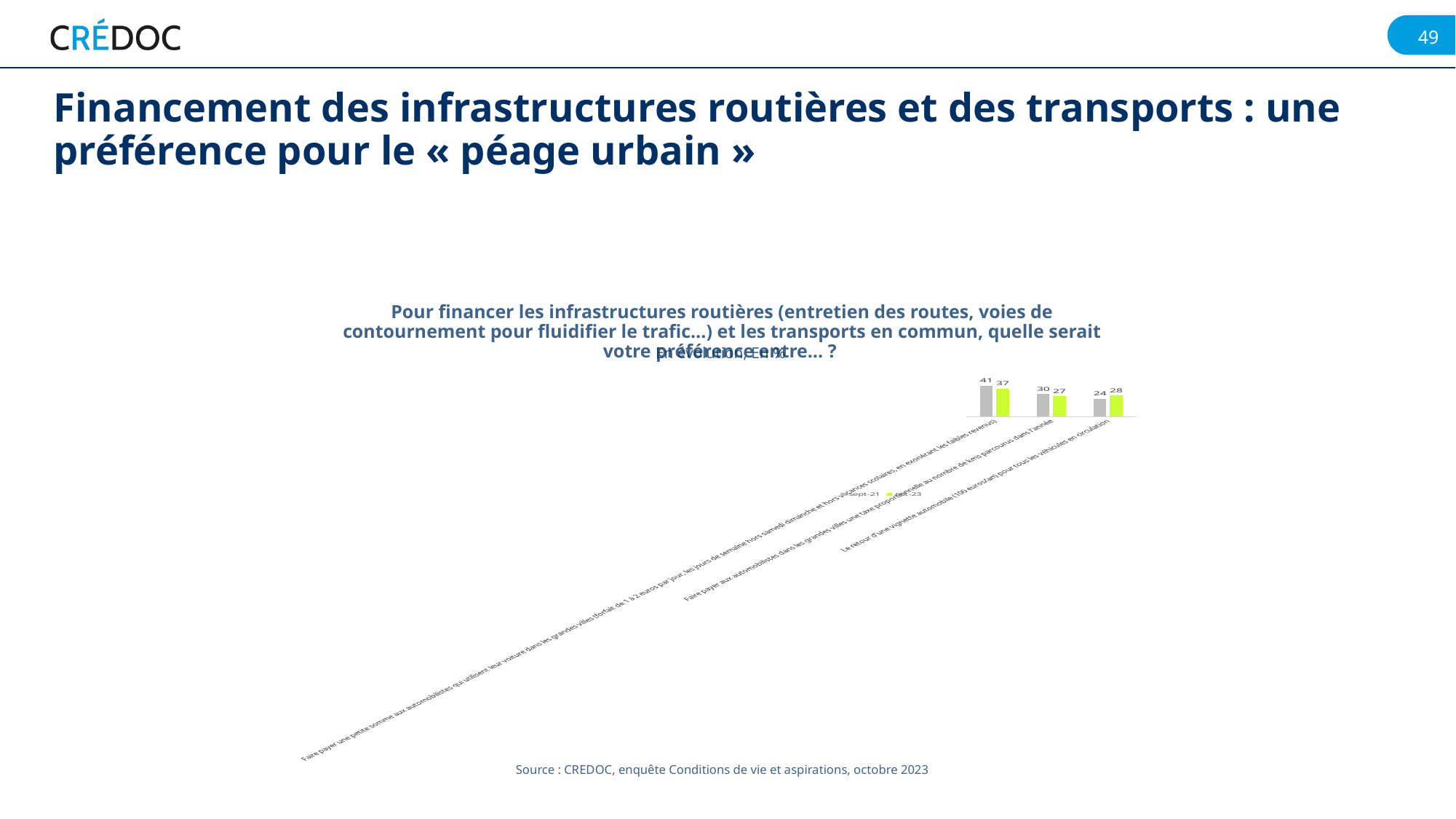
What kind of chart is shown on the slide? bar chart What is the Sept-21 value for the first category (the small daily charge for motorists using their car in large cities)? 41 What is the Sept-21 value for the tax proportional to the number of kilometres driven per year? 30 How many series does the chart legend list? 2 Which category has the lowest Sept-21 value? Le retour d'une vignette automobile (100 euros/an) How many categories (financing options) are plotted in the chart? 3